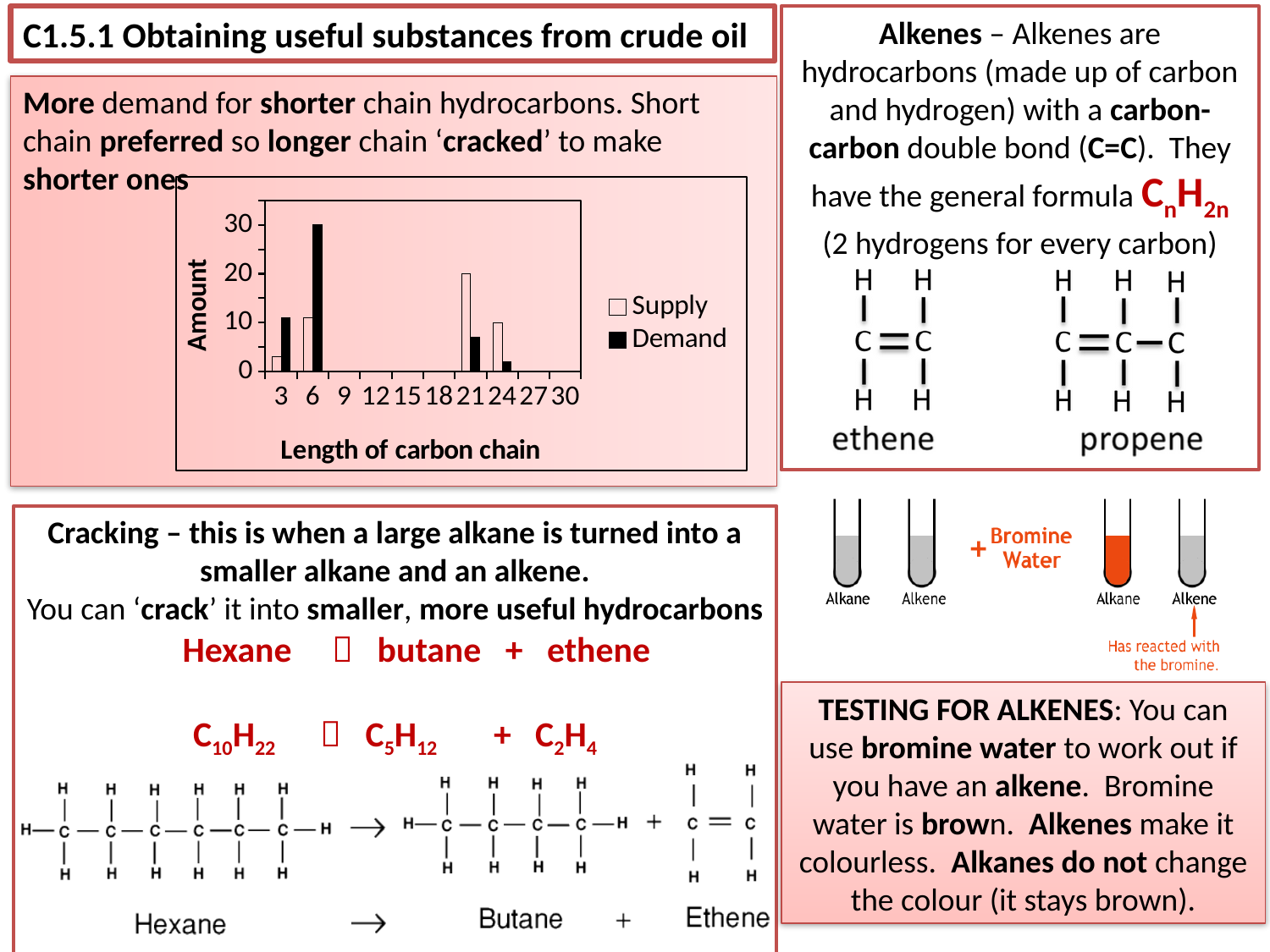
At which carbon chain length is Demand highest? 6 What is the Demand value at carbon chain length 6? 30 At which carbon chain length is Supply highest? 21 Is the Demand value at carbon chain length 3 greater or less than 20? less What is the Supply value at carbon chain length 24? 10 What kind of chart is shown on the slide? bar chart How many series does the chart's legend list? 2 At carbon chain length 6, which is larger, Supply or Demand? Demand What is the Supply value at carbon chain length 21? 20 What are the two series named in the chart's legend? Supply and Demand What is the title of the chart's x axis? Length of carbon chain At carbon chain length 21, which is larger, Supply or Demand? Supply